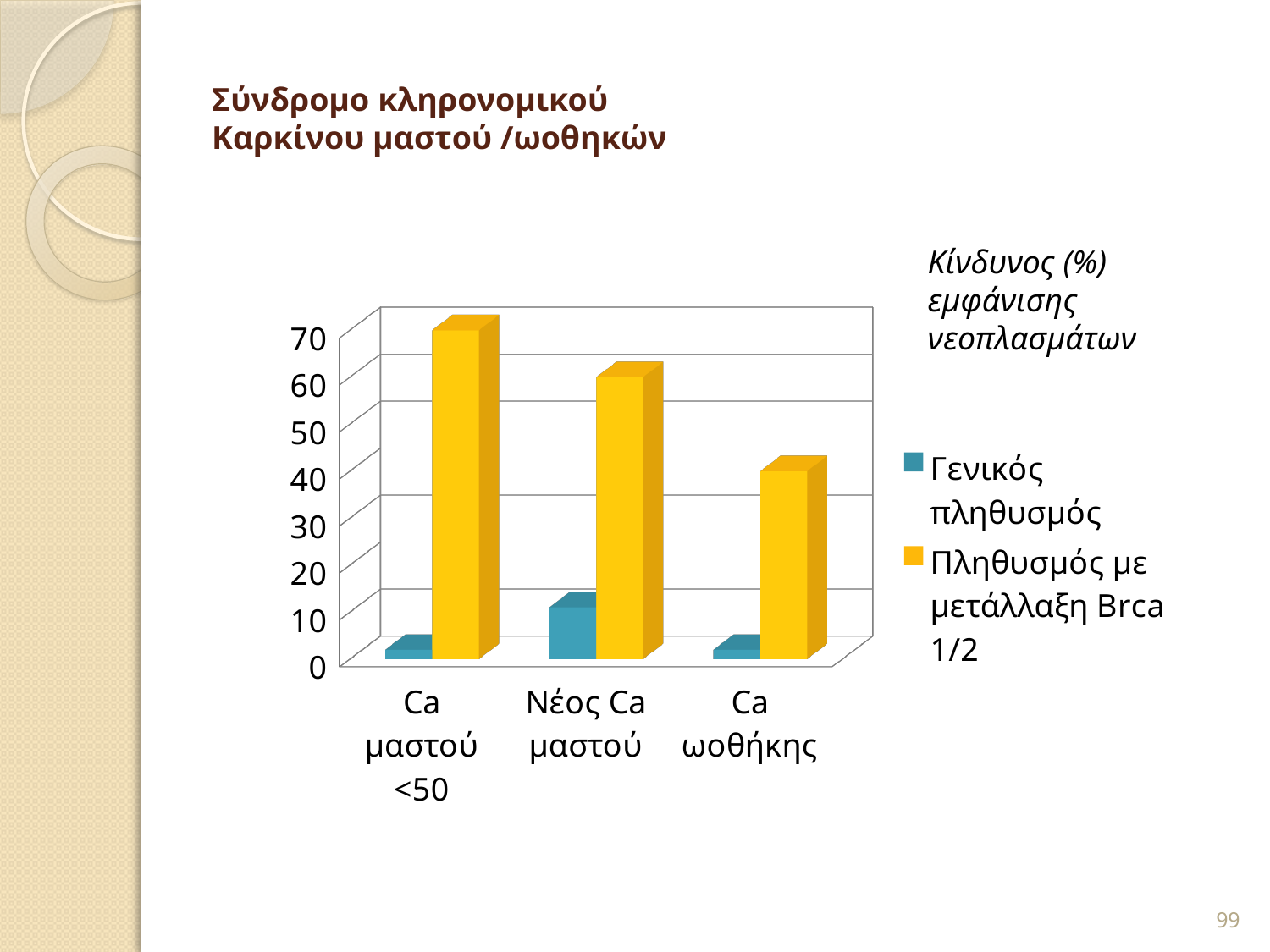
How many series does the chart's legend list? 2 Is the value for 'Πληθυσμός με μετάλλαξη Brca 1/2' in the category 'Ca ωοθήκης' greater or less than 50? less Is the value for 'Πληθυσμός με μετάλλαξη Brca 1/2' in the category 'Ca μαστού <50' greater or less than 60? greater Which category has the lowest value for the series 'Πληθυσμός με μετάλλαξη Brca 1/2'? Ca ωοθήκης Is the value for 'Γενικός πληθυσμός' in the category 'Ca μαστού <50' greater or less than 10? less Which category has the highest value for the series 'Πληθυσμός με μετάλλαξη Brca 1/2'? Ca μαστού <50 For the category 'Νέος Ca μαστού', which series has the larger value: 'Γενικός πληθυσμός' or 'Πληθυσμός με μετάλλαξη Brca 1/2'? Πληθυσμός με μετάλλαξη Brca 1/2 What is the highest tick value shown on the chart's vertical axis? 70 What kind of chart is shown on the slide? bar chart Which series is shown in yellow in the chart? Πληθυσμός με μετάλλαξη Brca 1/2 How many categories are shown on the x axis of the chart? 3 Which category has the highest value for the series 'Γενικός πληθυσμός'? Νέος Ca μαστού